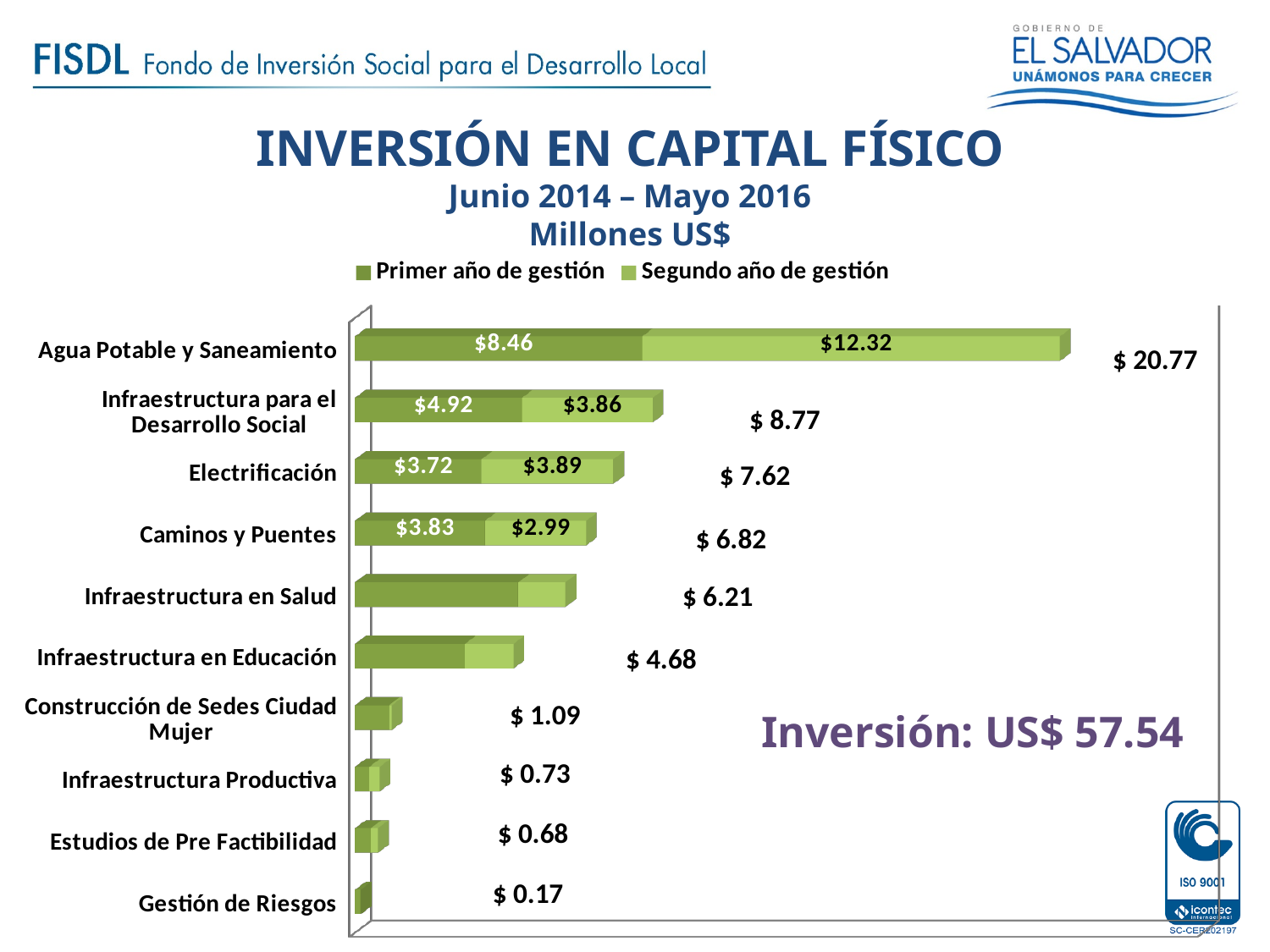
What is the total of the stacked bar for Caminos y Puentes? $ 6.82 What is the value of Segundo año de gestión for Electrificación? $3.89 How many series does the legend list? 2 What are the two series named in the legend? Primer año de gestión and Segundo año de gestión What is the total investment shown for Infraestructura en Salud? $ 6.21 Which category has the highest total investment? Agua Potable y Saneamiento Which category has the lowest total investment? Gestión de Riesgos What is the value of Primer año de gestión for Agua Potable y Saneamiento? $8.46 Which has a larger total investment, Electrificación or Caminos y Puentes? Electrificación How many categories are shown in the chart? 10 What is the difference between the total for Agua Potable y Saneamiento and the total for Infraestructura para el Desarrollo Social? $ 12.00 What kind of chart is shown on the slide? Stacked bar chart